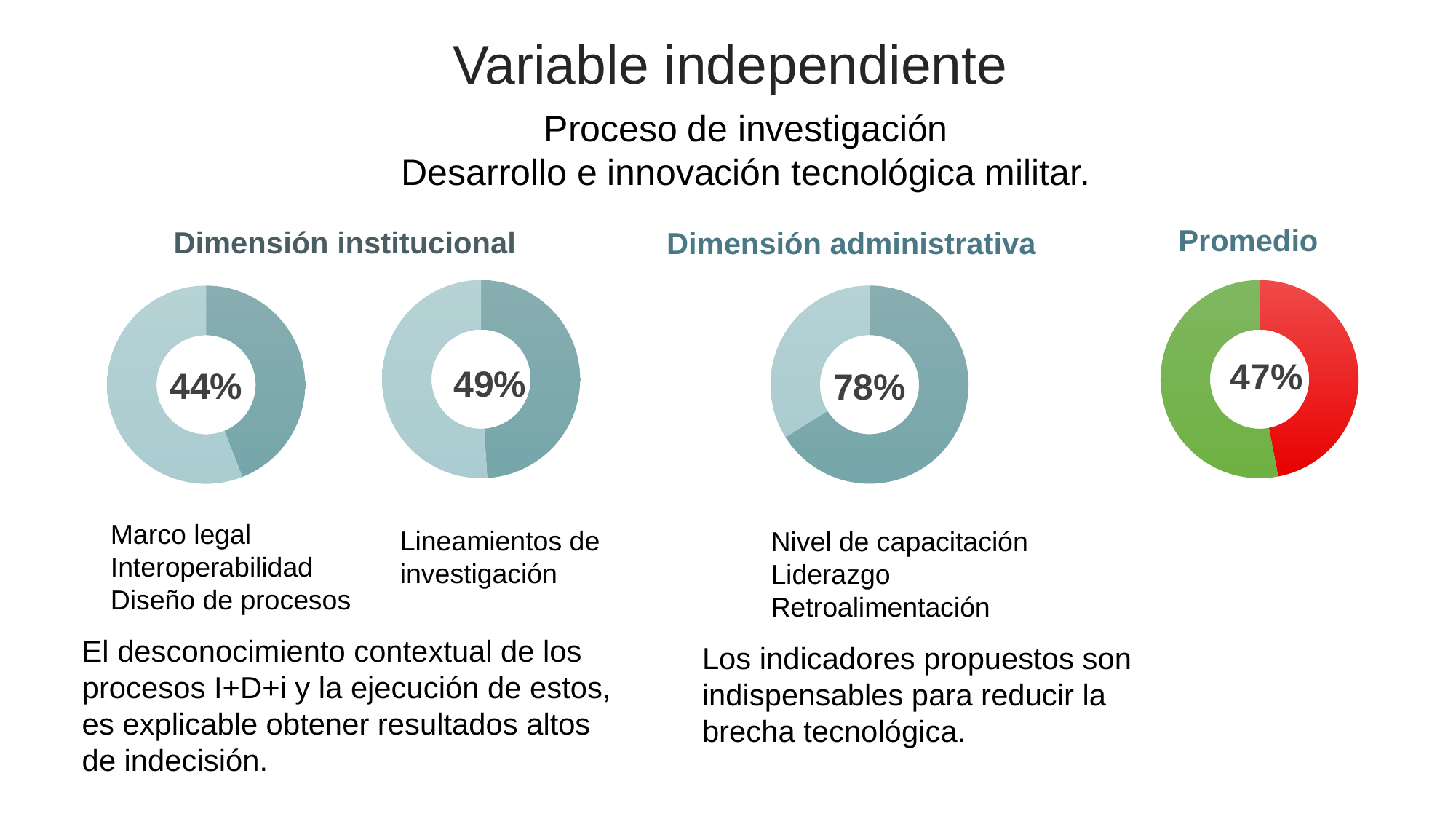
Which is larger: the percentage in the "Lineamientos de investigación" donut or the "Promedio" donut? Lineamientos de investigación (49%) What is the difference between the percentage in the "Dimensión administrativa" donut and the "Promedio" donut? 31% What percentage is shown in the donut chart labelled "Lineamientos de investigación"? 49% Which of the four donut charts shows the highest percentage? Dimensión administrativa (78%) What is the difference between the two donut charts under "Dimensión institucional" (49% and 44%)? 5% What two colours are used in the "Promedio" donut chart? Green and red What percentage is shown in the centre of the first donut chart under "Dimensión institucional" (Marco legal, Interoperabilidad, Diseño de procesos)? 44% How many donut charts are shown on the slide? 4 What percentage is shown in the donut chart under "Dimensión administrativa"? 78% What percentage is shown in the "Promedio" donut chart? 47% What type of chart is used to display the percentages on the slide? Donut (pie) chart Which of the four donut charts shows the lowest percentage? The first Dimensión institucional chart (44%)